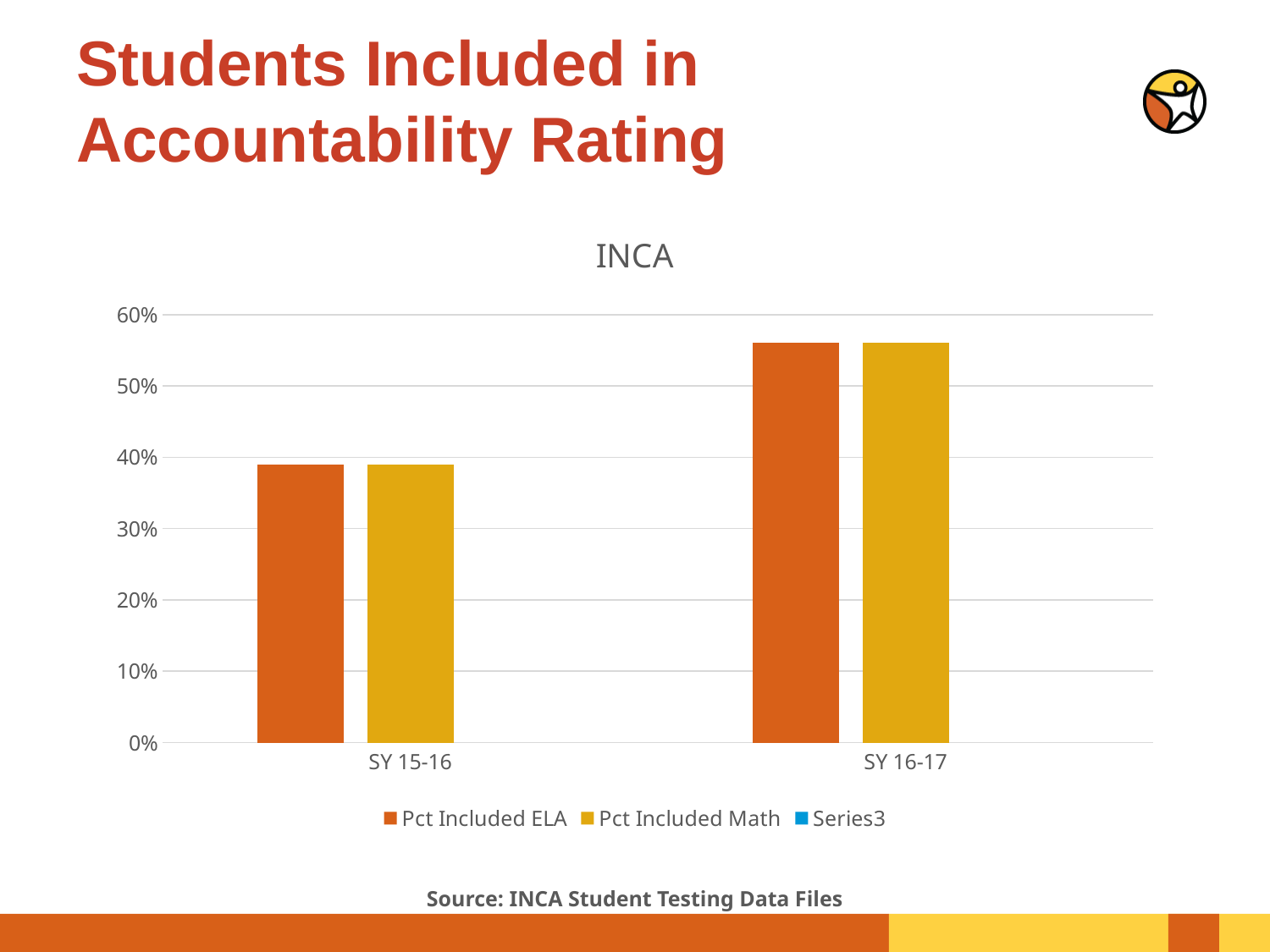
Which school year has the higher Pct Included ELA value? SY 16-17 Is the Pct Included ELA value for SY 16-17 larger or smaller than the Pct Included ELA value for SY 15-16? larger How many series does the legend list? 3 What is the title of the chart? INCA Do the Pct Included ELA values rise or fall from SY 15-16 to SY 16-17? rise Is the Pct Included Math value for SY 15-16 greater or less than 30%? greater Is the Pct Included ELA value for SY 16-17 greater or less than 50%? greater Is the Pct Included Math value for SY 16-17 greater or less than 60%? less What kind of chart is shown on the slide? bar chart How many school-year categories are shown on the x axis? 2 What is the name of the third series listed in the legend? Series3 Which school year has the lower Pct Included Math value? SY 15-16